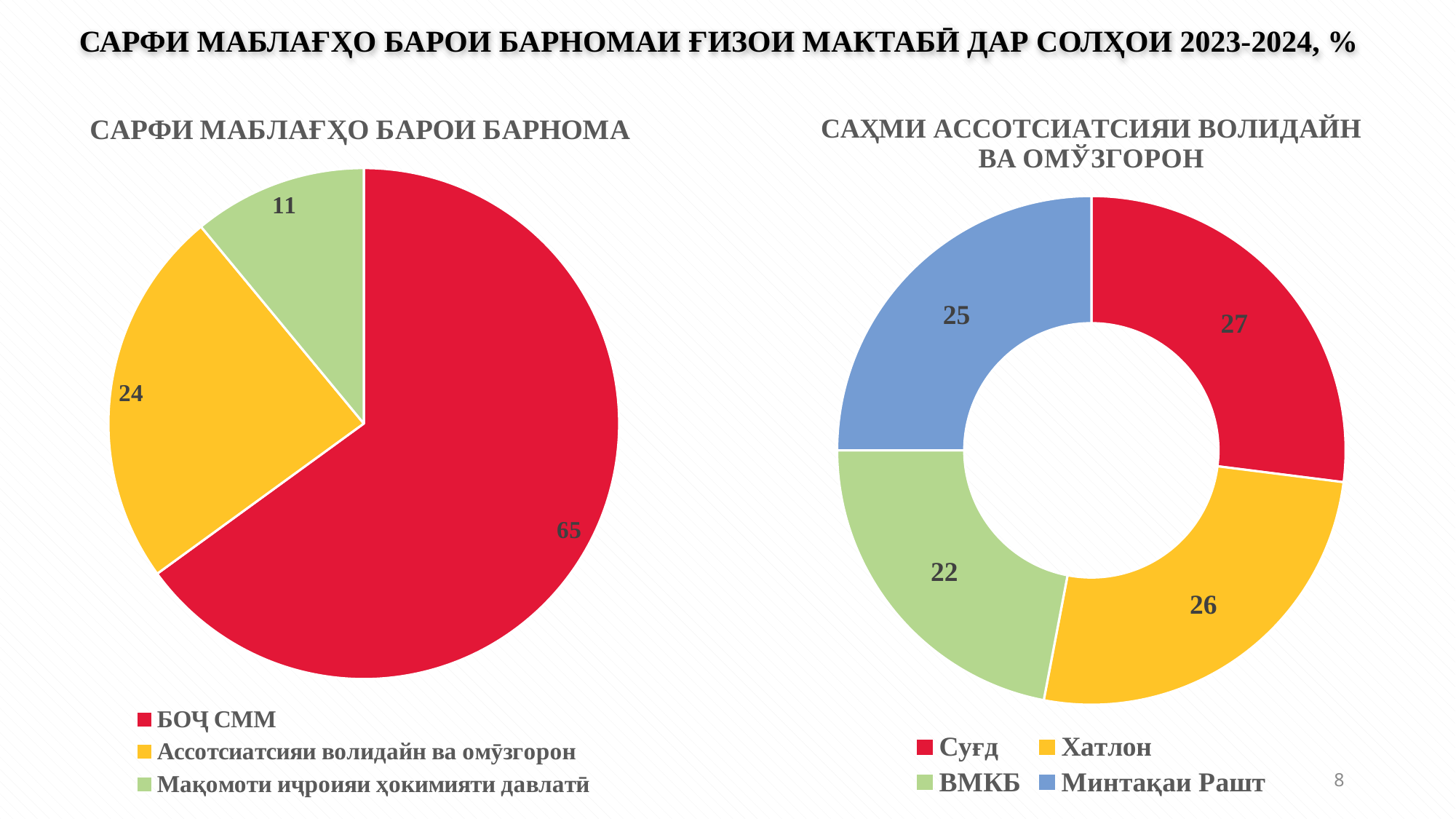
In the right chart (САҲМИ АССОТСИАТСИЯИ ВОЛИДАЙН ВА ОМӮЗГОРОН), which region has the highest value? Суғд In the right chart (САҲМИ АССОТСИАТСИЯИ ВОЛИДАЙН ВА ОМӮЗГОРОН), which region has the lowest value? ВМКБ In the right chart (САҲМИ АССОТСИАТСИЯИ ВОЛИДАЙН ВА ОМӮЗГОРОН), what is the value for Минтақаи Рашт? 25 In the left chart (САРФИ МАБЛАҒҲО БАРОИ БАРНОМА), what is the value for БОҶ СММ? 65 In the right chart (САҲМИ АССОТСИАТСИЯИ ВОЛИДАЙН ВА ОМӮЗГОРОН), how many regions does the legend list? 4 In the left chart (САРФИ МАБЛАҒҲО БАРОИ БАРНОМА), what is the value for Ассотсиатсияи волидайн ва омӯзгорон? 24 In the right chart (САҲМИ АССОТСИАТСИЯИ ВОЛИДАЙН ВА ОМӮЗГОРОН), what is the value for Хатлон? 26 In the right chart (САҲМИ АССОТСИАТСИЯИ ВОЛИДАЙН ВА ОМӮЗГОРОН), what colour represents ВМКБ? Green In the left chart (САРФИ МАБЛАҒҲО БАРОИ БАРНОМА), which category has the smallest slice? Мақомоти иҷроияи ҳокимияти давлатӣ What type of chart is the left chart (САРФИ МАБЛАҒҲО БАРОИ БАРНОМА)? Pie chart In the left chart (САРФИ МАБЛАҒҲО БАРОИ БАРНОМА), how many categories are shown? 3 In the left chart (САРФИ МАБЛАҒҲО БАРОИ БАРНОМА), what is the difference between the values for БОҶ СММ and Ассотсиатсияи волидайн ва омӯзгорон? 41